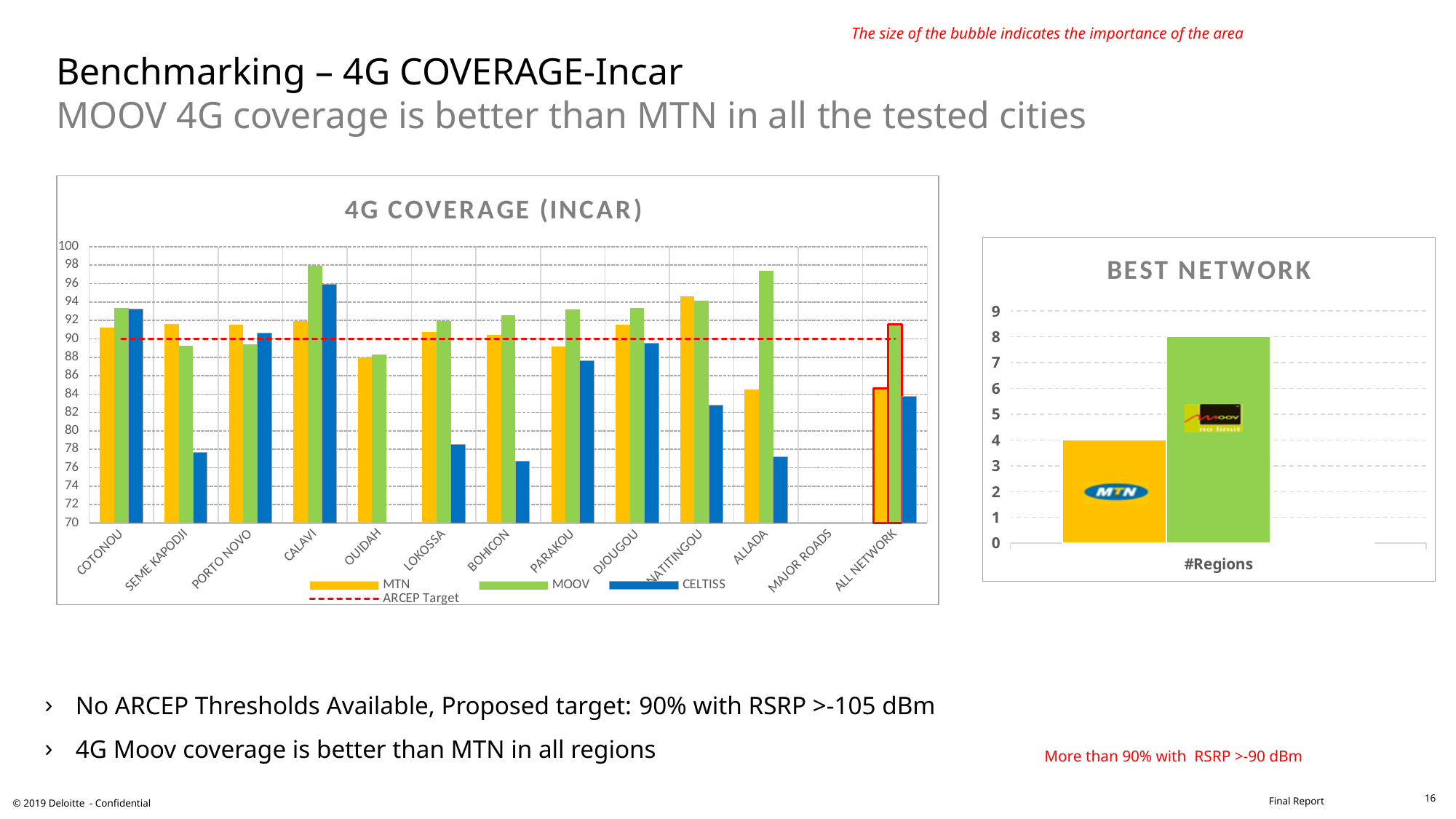
In the 4G COVERAGE (INCAR) chart, is the MOOV value for CALAVI greater or less than 96? greater In the 4G COVERAGE (INCAR) chart, is the MTN value for ALLADA greater or less than 90? less In the BEST NETWORK chart, which network has the higher number of regions? MOOV In the 4G COVERAGE (INCAR) chart, how many categories are shown on the x axis? 13 In the BEST NETWORK chart, what is the value for MTN? 4 In the BEST NETWORK chart, what is the value for MOOV? 8 What kind of chart is the 4G COVERAGE (INCAR) chart? Combination bar and line chart In the 4G COVERAGE (INCAR) chart, is the CELTISS value for SEME KAPODJI greater or less than 80? less In the 4G COVERAGE (INCAR) chart, which is larger for SEME KAPODJI, the MTN value or the CELTISS value? MTN In the 4G COVERAGE (INCAR) chart, how many entries does the legend list? 4 In the BEST NETWORK chart, what is the difference between the MOOV and MTN values? 4